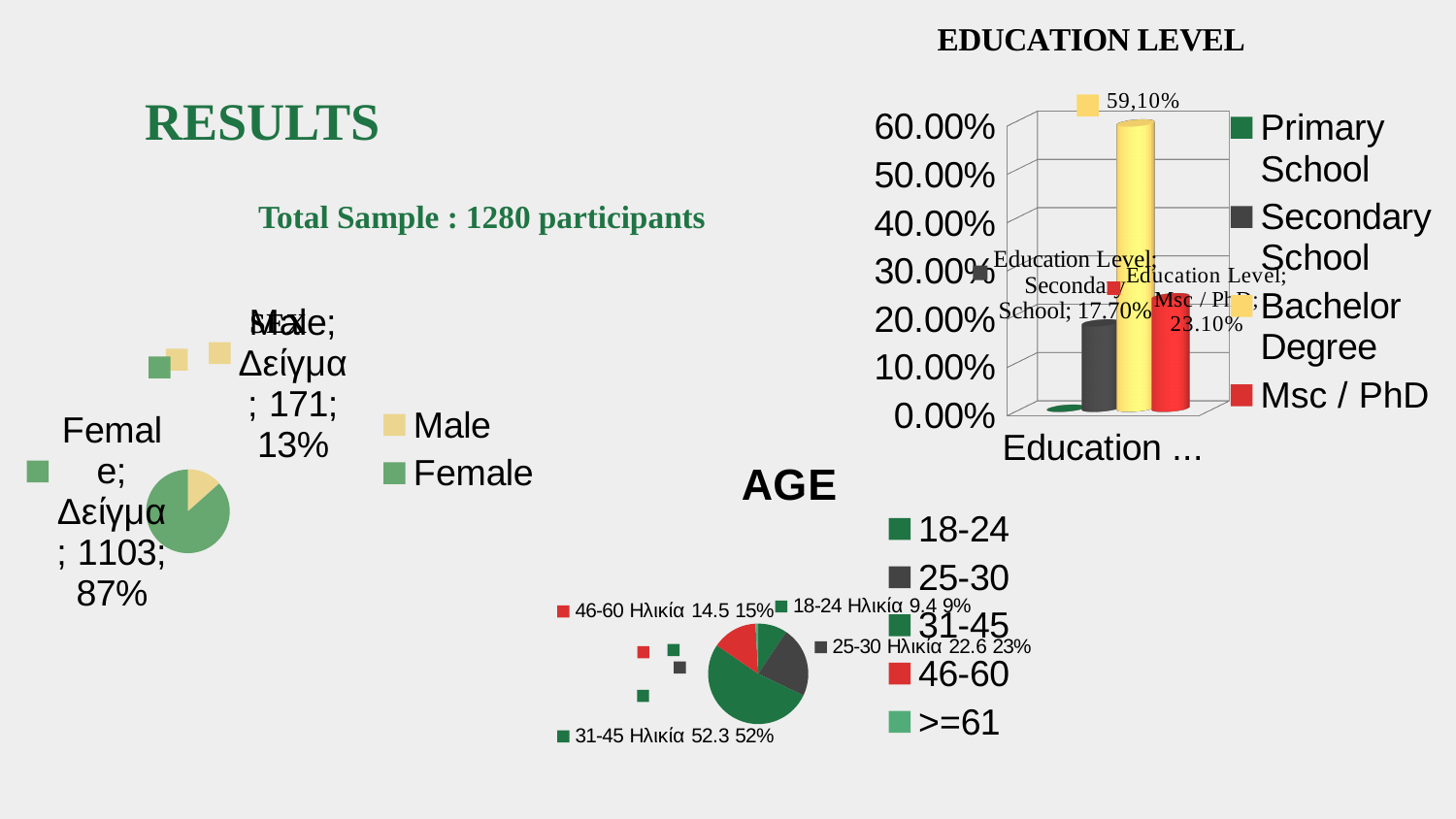
In the EDUCATION LEVEL chart, which education level has the highest value? Bachelor Degree How many entries does the legend of the AGE pie chart list? 5 In the gender pie chart on the left, what percentage of the sample is Female? 87% In the gender pie chart on the left, how many participants are Male? 171 What kind of chart is the EDUCATION LEVEL chart? Bar chart In the EDUCATION LEVEL chart, which is larger: Secondary School or Msc / PhD? Msc / PhD In the EDUCATION LEVEL chart, what is the value for Secondary School? 17.70% In the AGE pie chart, what percentage share does the 31-45 age group have? 52% In the EDUCATION LEVEL chart, what is the value for Bachelor Degree? 59,10% In the EDUCATION LEVEL chart, which education level has the lowest value? Primary School In the gender pie chart on the left, how many more Female participants are there than Male participants? 932 How many entries does the legend of the gender pie chart on the left list? 2